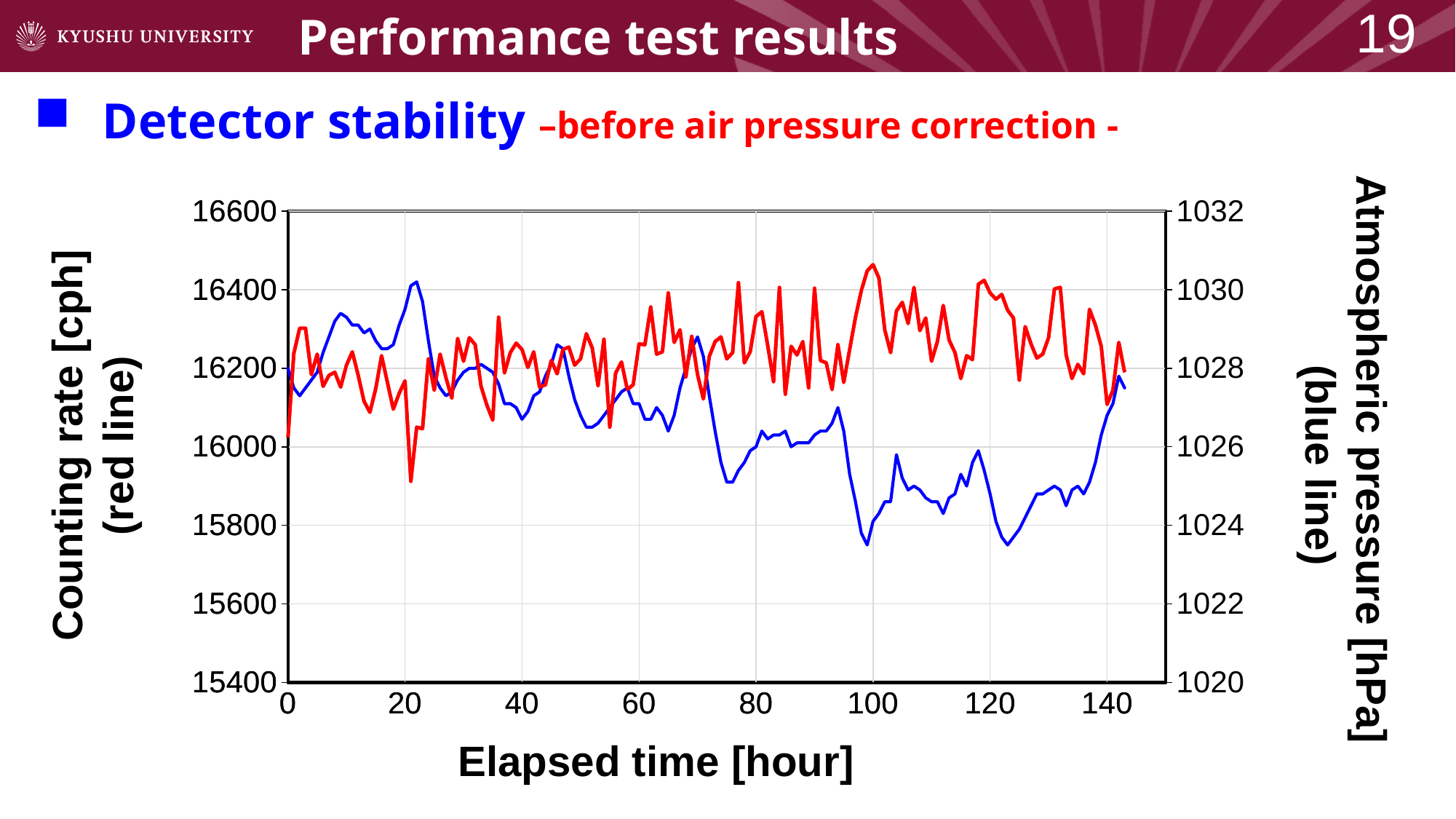
Which quantity does the blue line represent? Atmospheric pressure [hPa] Does the atmospheric pressure (blue line) generally rise or fall between 60 and 100 hours? fall How many lines are plotted on the chart? 2 Is the atmospheric pressure (blue line) at around 140 hours greater or less than 1026 hPa? greater Is the atmospheric pressure (blue line) at around 20 hours greater or less than 1028 hPa? greater What is the title of the x axis of the chart? Elapsed time [hour] What kind of chart is shown on the slide? line chart Is the counting rate (red line) higher at around 100 hours or at around 20 hours? around 100 hours Is the counting rate (red line) at around 100 hours greater or less than 16400 cph? greater